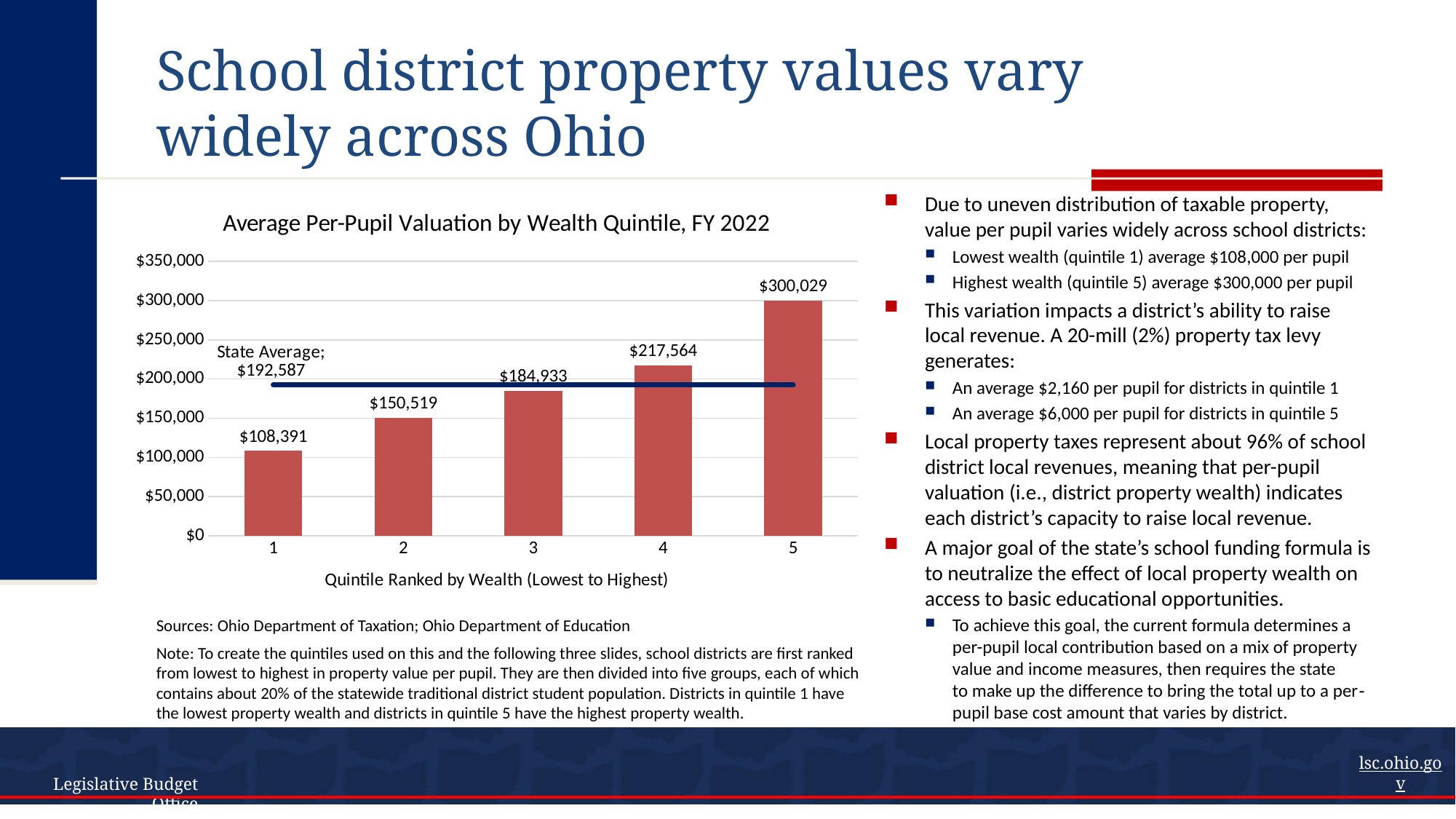
What is the average per-pupil valuation for quintile 1? $108,391 Is the value for quintile 2 greater or less than $200,000? less How many quintiles are plotted on the chart? 5 Which is larger, the per-pupil valuation for quintile 3 or the state average? State average What is the difference between the per-pupil valuation of quintile 4 and quintile 2? $67,045 What is the difference between the per-pupil valuation of quintile 5 and quintile 1? $191,638 What is the state average per-pupil valuation shown on the chart? $192,587 Which quintile has the highest average per-pupil valuation? 5 Do the per-pupil valuations rise or fall from quintile 1 to quintile 5? rise What is the average per-pupil valuation for quintile 3? $184,933 What is the average per-pupil valuation for quintile 5? $300,029 Which quintile has the lowest average per-pupil valuation? 1